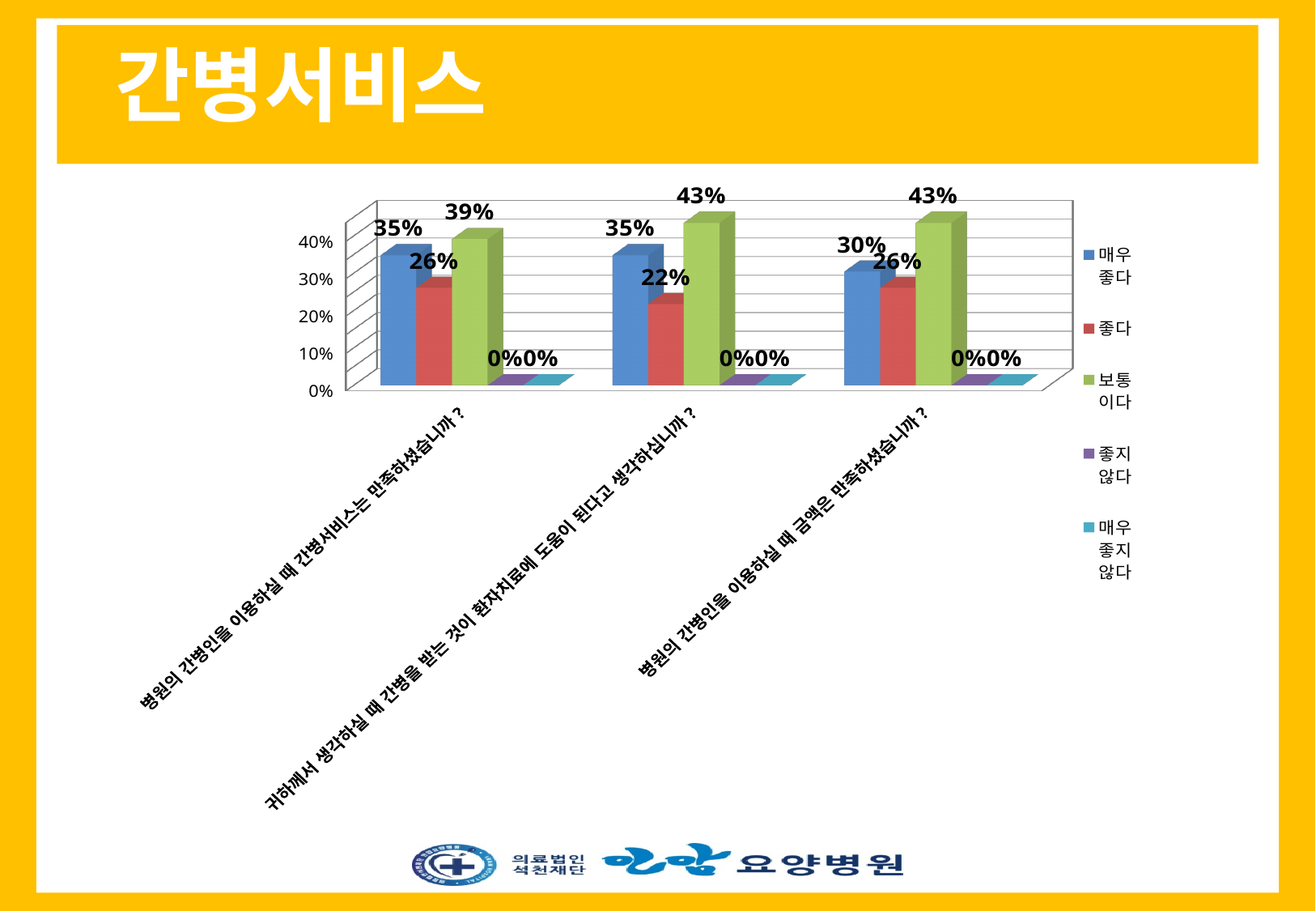
What type of chart is shown on the slide? bar chart How many categories (survey questions) are shown on the x axis? 3 What is the title of the slide? 간병서비스 What is the value of 매우 좋다 for the category '병원의 간병인을 이용하실 때 간병서비스는 만족하셨습니까?'? 35% What is the value of 매우 좋다 for the category '병원의 간병인을 이용하실 때 금액은 만족하셨습니까?'? 30% What is the value of 보통이다 for the category '귀하께서 생각하실 때 간병을 받는 것이 환자치료에 도움이 된다고 생각하십니까?'? 43% Which is larger for the category '병원의 간병인을 이용하실 때 간병서비스는 만족하셨습니까?': 매우 좋다 or 좋다? 매우 좋다 Which series has the highest value for the category '병원의 간병인을 이용하실 때 간병서비스는 만족하셨습니까?'? 보통이다 What is the value of 좋지 않다 for the category '병원의 간병인을 이용하실 때 금액은 만족하셨습니까?'? 0% What is the difference between 보통이다 and 매우 좋다 for the category '귀하께서 생각하실 때 간병을 받는 것이 환자치료에 도움이 된다고 생각하십니까?'? 8% What is the value of 좋다 for the category '병원의 간병인을 이용하실 때 금액은 만족하셨습니까?'? 26% How many series does the legend list? 5